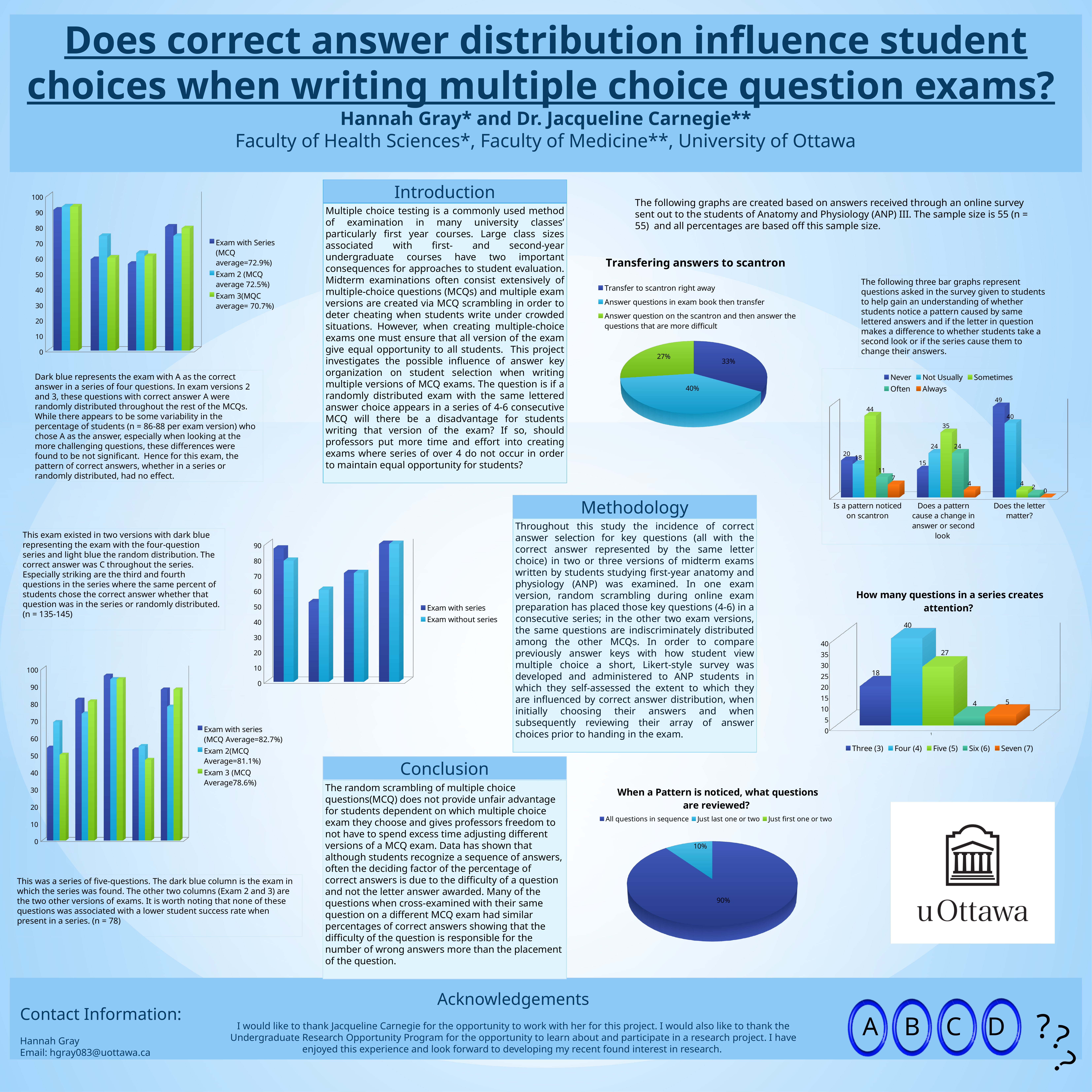
In the bar chart with the Never/Not Usually/Sometimes/Often/Always legend, what is the 'Never' value for 'Does the letter matter?'? 49 In the bar chart with the Never/Not Usually/Sometimes/Often/Always legend, what is the 'Sometimes' value for 'Is a pattern noticed on scantron'? 44 In the 'When a Pattern is noticed, what questions are reviewed?' pie chart, what share is 'Just last one or two'? 10% In the 'How many questions in a series creates attention?' chart, how many series does the legend list? 5 In the bar chart with the Never/Not Usually/Sometimes/Often/Always legend, which is larger for 'Does a pattern cause a change in answer or second look': 'Not Usually' or 'Sometimes'? Sometimes In the 'How many questions in a series creates attention?' chart, which series length has the lowest value? Six (6) What kind of chart is the top-left chart with the 'Exam with Series', 'Exam 2' and 'Exam 3' legend? Bar chart In the 'How many questions in a series creates attention?' chart, what is the difference between the values for Four (4) and Five (5)? 13 In the 'Transfering answers to scantron' pie chart, what percentage of students answer questions in the exam book then transfer? 40% In the 'Transfering answers to scantron' pie chart, which option has the smallest share? Answer question on the scantron and then answer the questions that are more difficult In the 'Transfering answers to scantron' pie chart, what is the difference between the share that transfers to scantron right away and the share that answers on the scantron first? 6% In the 'How many questions in a series creates attention?' chart, what is the value for Four (4)? 40